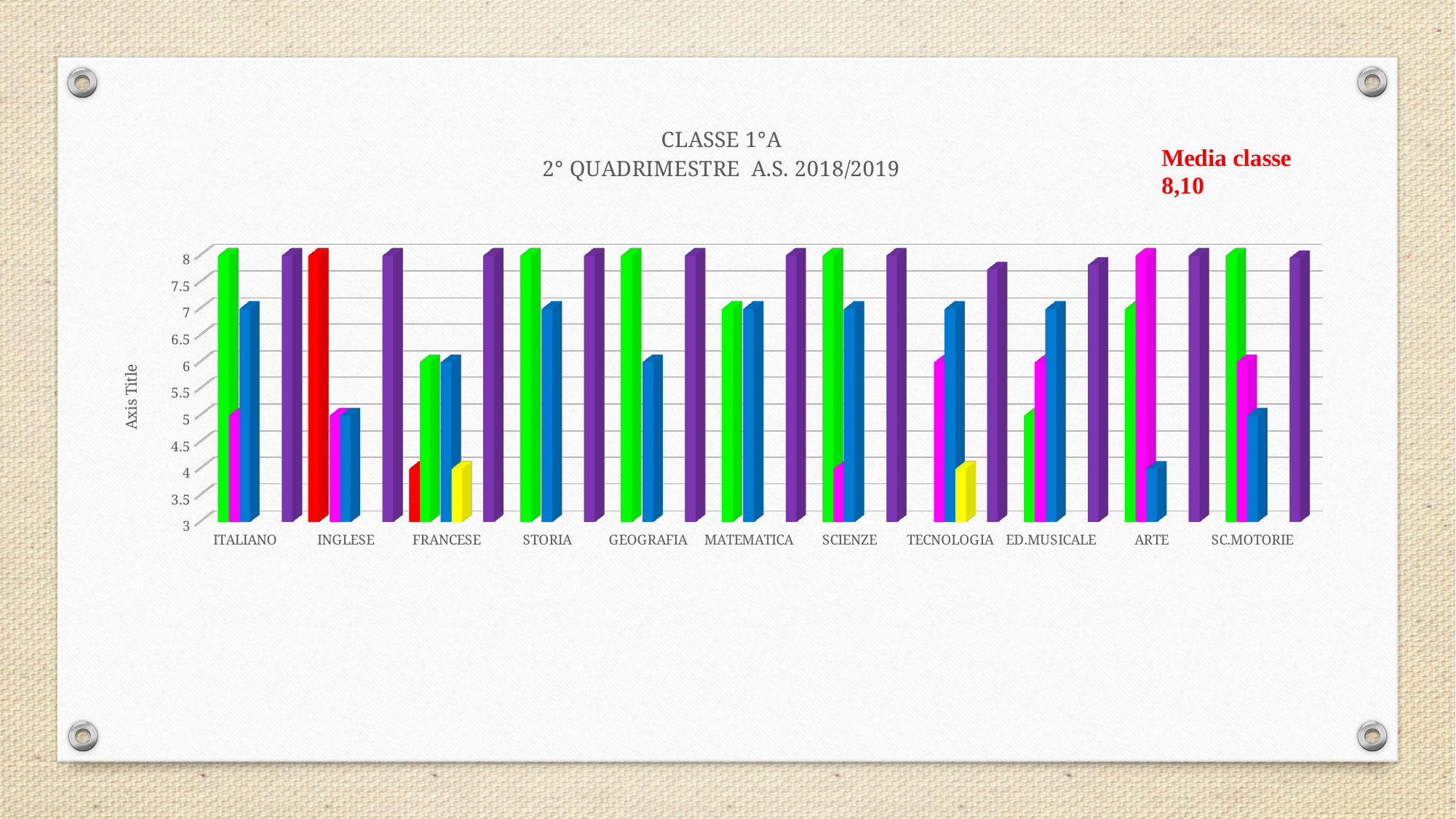
Is the value of the blue bar for GEOGRAFIA greater or less than 7? less How many subject categories are shown on the x axis of the chart? 11 What is the highest value shown on the vertical axis of the chart? 8 Is the value of the blue bar for ARTE greater or less than 5? less Is the value of the green bar for STORIA greater or less than 7? greater What is the title of the chart? CLASSE 1°A 2° QUADRIMESTRE A.S. 2018/2019 What label is shown on the vertical axis of the chart? Axis Title What is the lowest value shown on the vertical axis of the chart? 3 What kind of chart is shown on the slide? bar chart